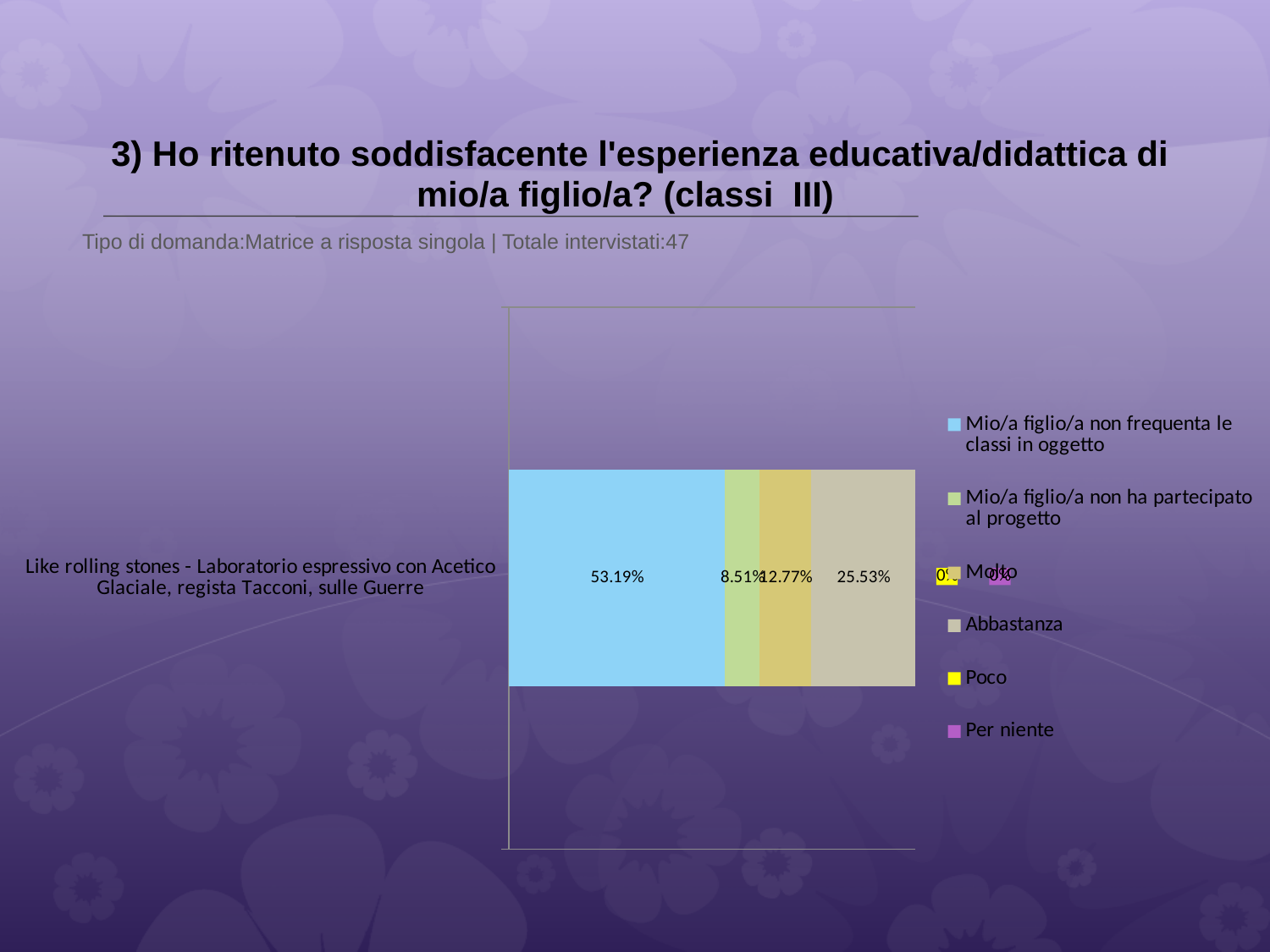
How many series does the legend list? 6 What is the value for 'Mio/a figlio/a non frequenta le classi in oggetto'? 53.19% Which is larger, the value for 'Molto' or the value for 'Abbastanza'? Abbastanza What is the total number of respondents stated in the subtitle? 47 What is the value for 'Mio/a figlio/a non ha partecipato al progetto'? 8.51% What kind of chart is shown on the slide? Stacked bar chart What is the difference between the values for 'Abbastanza' and 'Molto'? 12.76% What is the value for 'Molto'? 12.77% Which series has the highest value in the bar? Mio/a figlio/a non frequenta le classi in oggetto How many categories are plotted on the vertical axis? 1 What is the difference between the values for 'Mio/a figlio/a non frequenta le classi in oggetto' and 'Abbastanza'? 27.66% What is the value for 'Abbastanza'? 25.53%